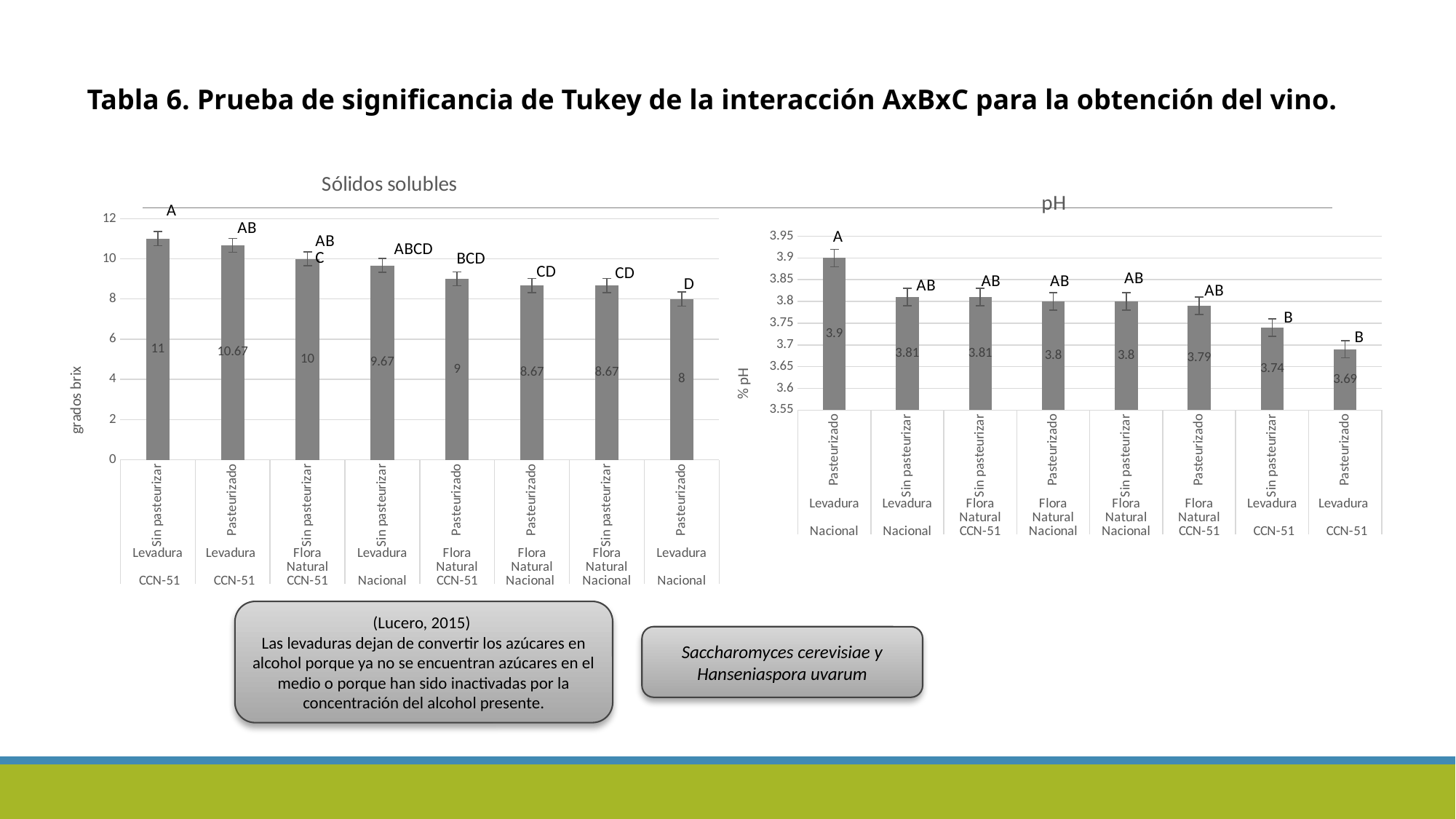
In the 'Sólidos solubles' chart, which category has the highest value? Sin pasteurizar, Levadura, CCN-51 In the 'pH' chart, what is the value for Pasteurizado, Levadura, Nacional? 3.9 In the 'Sólidos soluble' chart, what is the value for Sin pasteurizar, Levadura, CCN-51? 11 What kind of chart is the 'pH' chart? bar chart In the 'pH' chart, do the values rise or fall from left to right? fall In the 'Sólidos solubles' chart, what is the value for Pasteurizado, Levadura, Nacional? 8 In the 'Sólidos solubles' chart, how many bars are plotted? 8 In the 'Sólidos solubles' chart, what is the difference between Sin pasteurizar, Levadura, CCN-51 and Pasteurizado, Levadura, Nacional? 3 In the 'Sólidos solubles' chart, what is the y-axis label? grados brix In the 'pH' chart, which category has the lowest value? Pasteurizado, Levadura, CCN-51 In the 'pH' chart, what is the value for Pasteurizado, Levadura, CCN-51? 3.69 In the 'pH' chart, which is larger: Sin pasteurizar, Levadura, CCN-51 or Pasteurizado, Flora Natural, CCN-51? Pasteurizado, Flora Natural, CCN-51